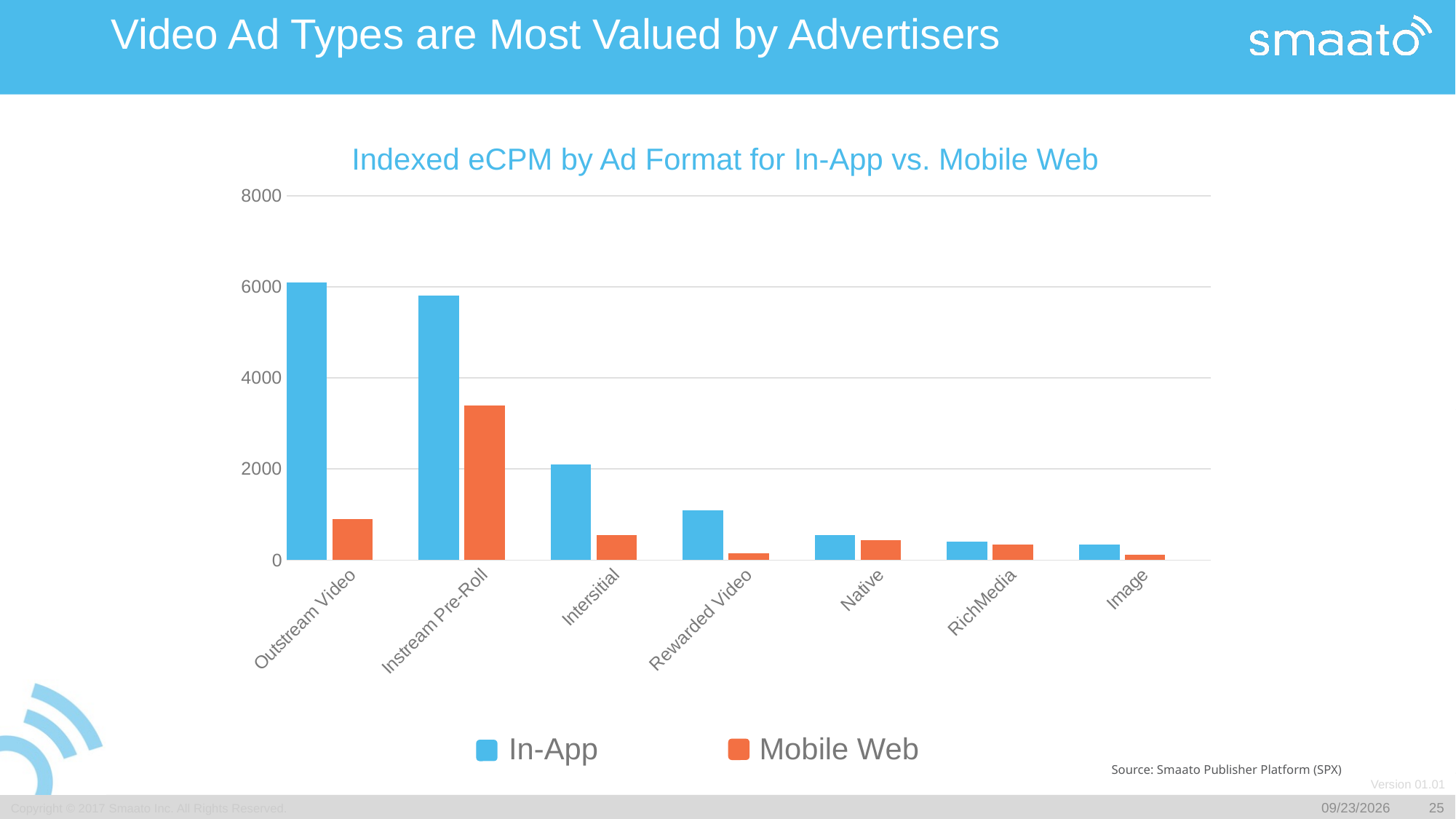
What kind of chart is shown on the slide? bar chart What is the title of the chart? Indexed eCPM by Ad Format for In-App vs. Mobile Web Is the In-App value for Rewarded Video greater or less than 2000? less How many series does the legend list? 2 Is the Mobile Web value for Instream Pre-Roll greater or less than 2000? greater Is the In-App value for Outstream Video greater or less than 4000? greater Do the In-App values rise or fall moving from left to right across the ad formats? fall For Interstitial, which is larger: the In-App value or the Mobile Web value? In-App Which ad format has the lowest Mobile Web indexed eCPM? Image How many ad format categories are shown on the x axis? 7 Which ad format has the highest Mobile Web indexed eCPM? Instream Pre-Roll Which ad format has the highest In-App indexed eCPM? Outstream Video